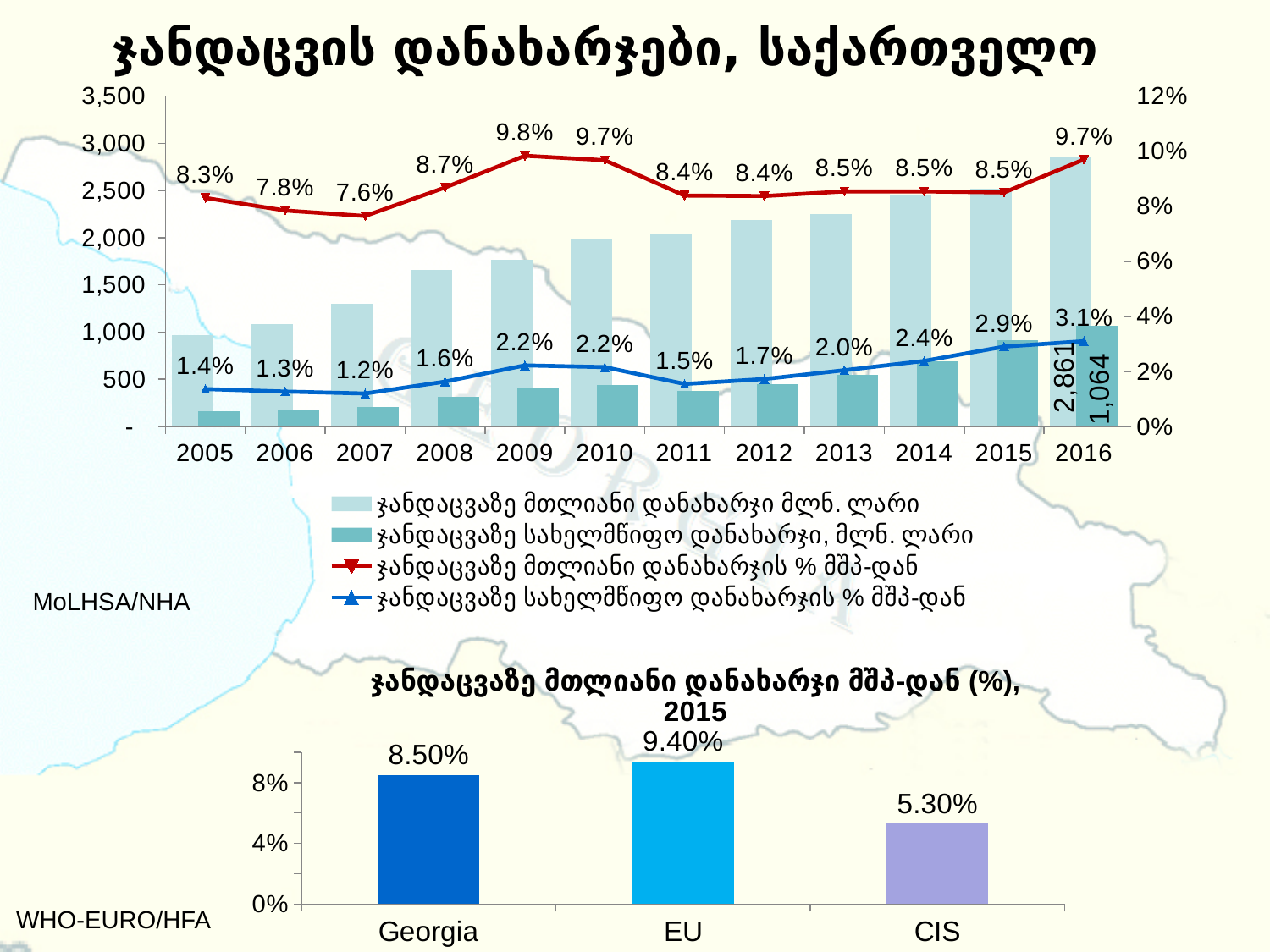
In the top chart, which year has the highest value on the blue line? 2016 In the top chart, which year has the lowest value on the red line? 2007 In the top chart, how many series does the legend list? 4 In the top chart, what is the difference between the red line values for 2009 and 2007? 2.2% In the bottom chart, what is the difference between the values for EU and CIS? 4.10% In the bottom chart, which category has the highest value? EU In the top chart, what is the value of the red line (total health expenditure as % of GDP) for 2009? 9.8% In the top chart, is the light blue bar for 2010 greater or less than 1,500? greater In the top chart, what is the data label on the light blue bar (total health expenditure, mln GEL) for 2016? 2,861 In the top chart, what is the value of the blue line (state health expenditure as % of GDP) for 2016? 3.1% In the top chart, what is the data label on the darker bar (state health expenditure, mln GEL) for 2016? 1,064 In the top chart, how many years are shown on the x axis? 12